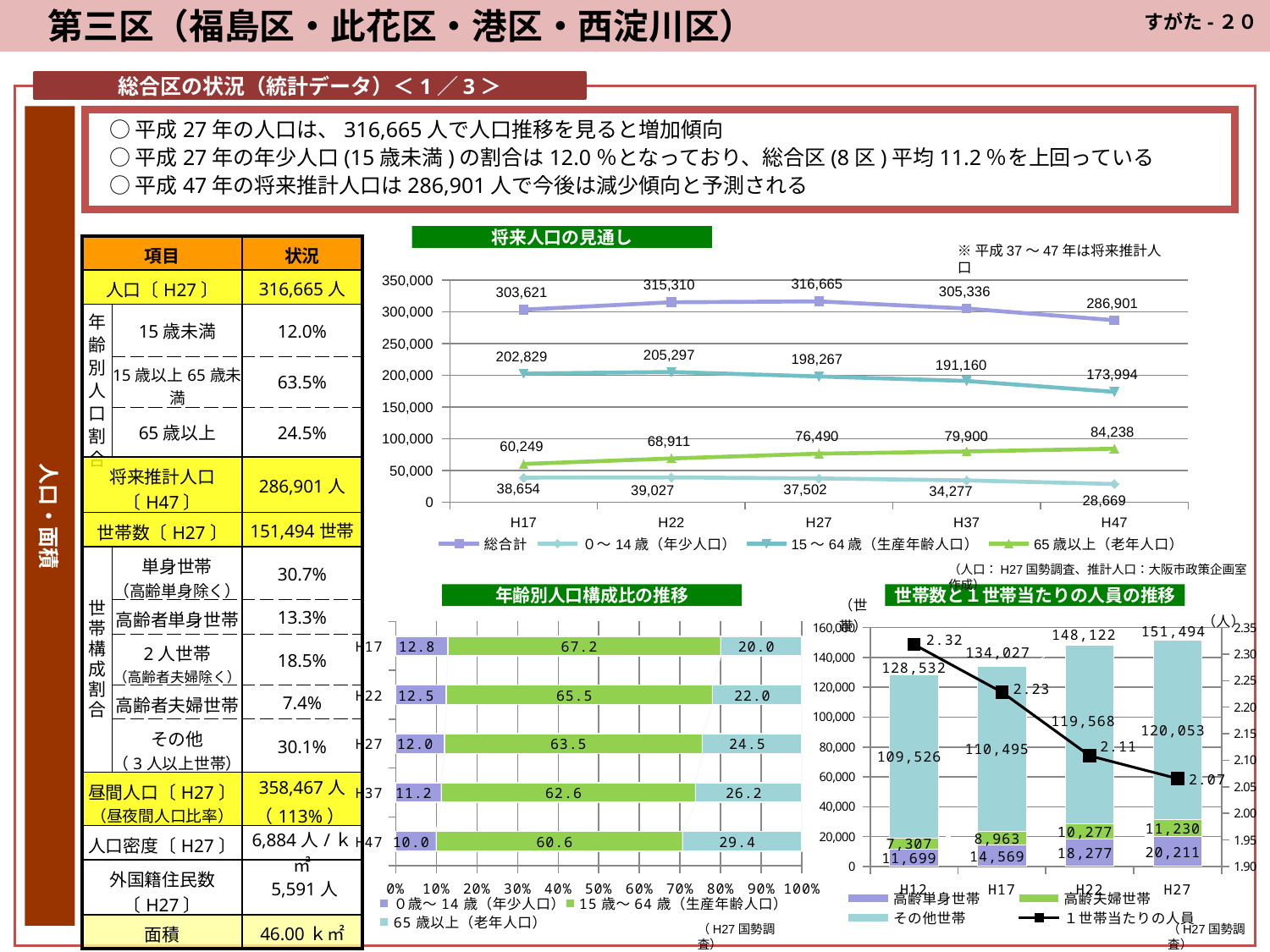
In the 世帯数と1世帯当たりの人員の推移 chart, what is the その他世帯 value for H22? 119,568 In the 将来人口の見通し chart, what is the 総合計 value for H27? 316,665 In the 年齢別人口構成比の推移 chart, what is the 65歳以上（老年人口） share for H37? 26.2 What kind of chart is the 将来人口の見通し chart? line chart In the 世帯数と1世帯当たりの人員の推移 chart, which is larger: the 高齢単身世帯 value for H12 or for H27? H27 In the 将来人口の見通し chart, does the 65歳以上（老年人口） series rise or fall from H17 to H47? rise In the 年齢別人口構成比の推移 chart, which year has the lowest 0歳～14歳（年少人口） share? H47 How many series does the legend of the 将来人口の見通し chart list? 4 In the 将来人口の見通し chart, what is the 0～14歳（年少人口） value for H47? 28,669 In the 世帯数と1世帯当たりの人員の推移 chart, what is the total of the stacked bar for H27? 151,494 In the 将来人口の見通し chart, which year has the highest 総合計 value? H27 In the 将来人口の見通し chart, what is the difference between the 15～64歳（生産年齢人口） values for H22 and H47? 31,303